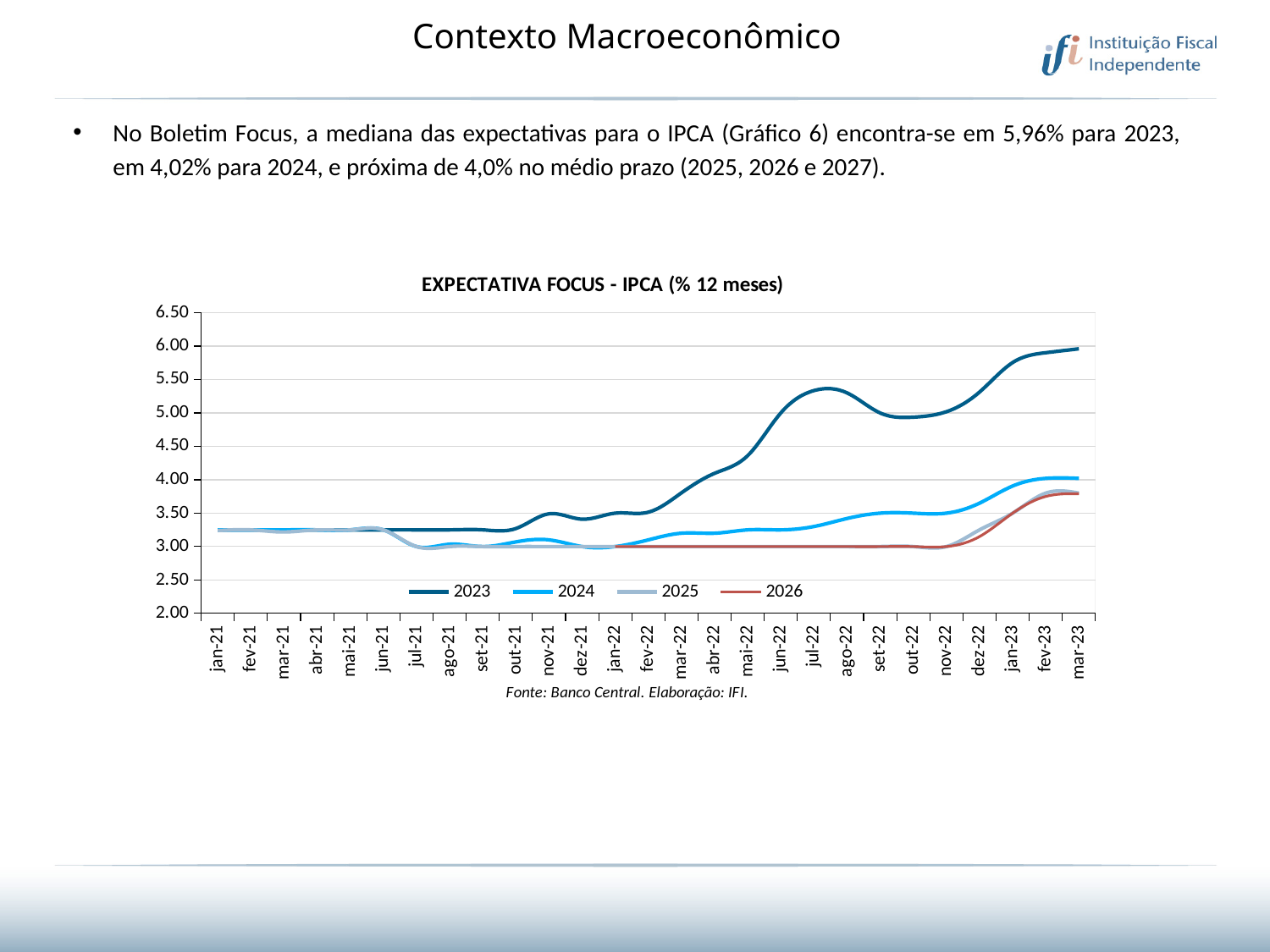
How many months are shown along the x axis of the chart? 27 How many series does the legend of the chart list? 4 What is the first month shown on the x axis of the chart? jan-21 Which series has the highest value at mar-23? 2023 What kind of chart is shown on the slide? line chart Does the 2023 series rise or fall overall between jan-22 and mar-23? rise What is the title of the chart? EXPECTATIVA FOCUS - IPCA (% 12 meses) At mar-23, which series has the larger value, 2023 or 2024? 2023 Is the value of the 2024 series at mar-23 greater or less than 3.50? greater Is the value of the 2023 series at jul-22 greater or less than 5.00? greater Is the value of the 2026 series at jan-22 greater or less than 3.50? less